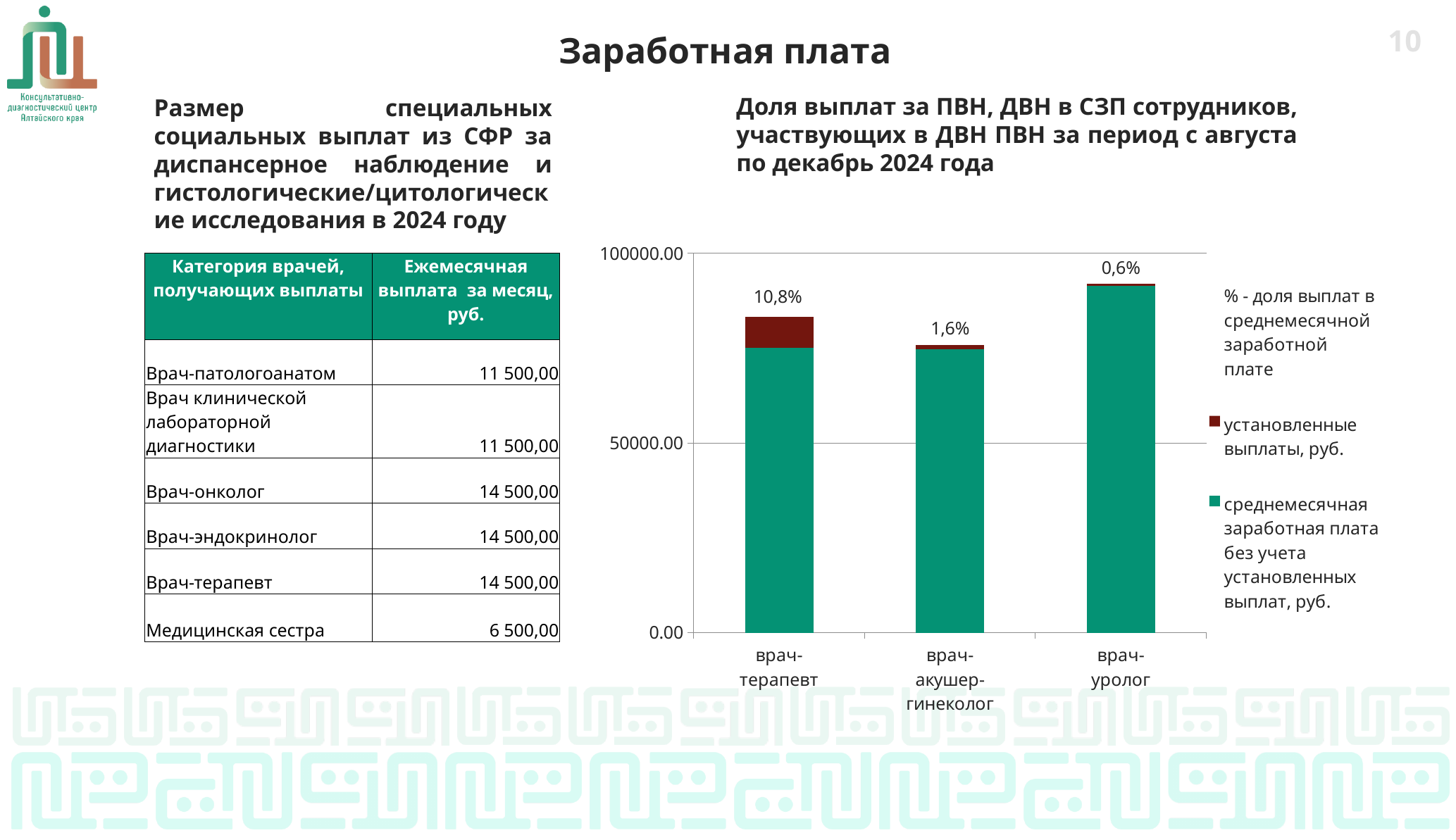
What percentage label is shown above the bar for врач-терапевт? 10,8% Which category has the lowest percentage share of payments shown on the chart? врач-уролог Which category has the highest percentage share of payments shown on the chart? врач-терапевт How many data series does the chart legend list? 3 How many categories are shown on the x axis of the chart? 3 Which bar is taller in total: врач-уролог or врач-терапевт? врач-уролог Which colour represents the series 'установленные выплаты, руб.' in the chart? dark red What percentage label is shown above the bar for врач-акушер-гинеколог? 1,6% What kind of chart is shown on the slide? stacked bar chart Is the total bar height for врач-акушер-гинеколог greater or less than 100000.00? less What percentage label is shown above the bar for врач-уролог? 0,6% Is the total bar height for врач-уролог greater or less than 50000.00? greater